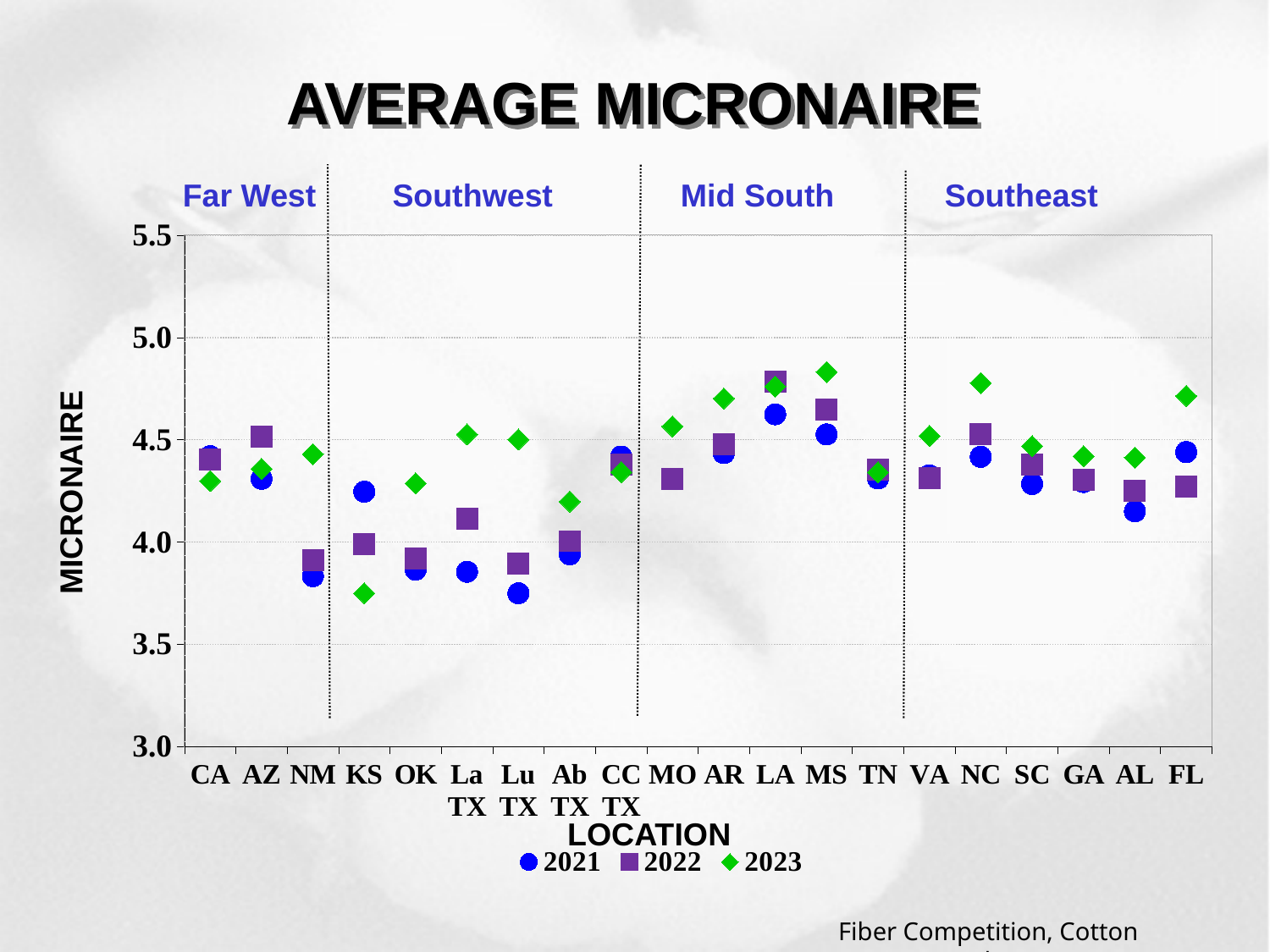
How many locations are plotted along the x axis? 20 Which location has the highest 2022 value? LA Is the 2021 value for Lu TX greater or less than 4.0? less For KS, which year has the larger value, 2021 or 2023? 2021 Which location has the lowest 2023 value? KS Is the 2023 value for FL greater or less than 4.5? greater Which four regions are labelled across the top of the chart? Far West, Southwest, Mid South, Southeast Is the 2021 value for LA greater or less than 4.5? greater What kind of chart is shown on the slide? Scatter (dot) chart How many series does the legend list? 3